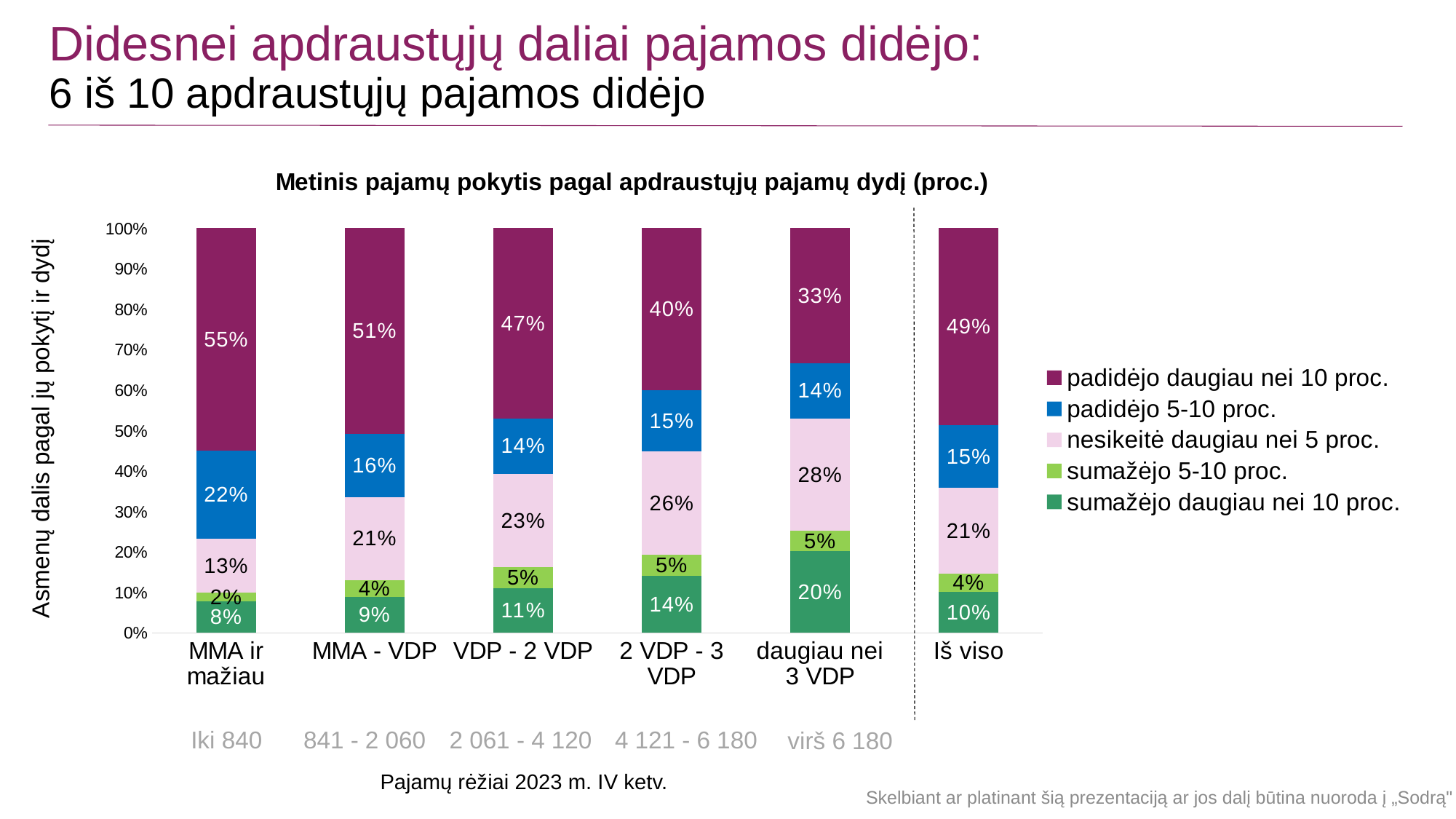
What is the value of 'padidėjo daugiau nei 10 proc.' for the 'MMA ir mažiau' category? 55% What is the difference between the 'padidėjo daugiau nei 10 proc.' values for 'MMA ir mažiau' and 'daugiau nei 3 VDP'? 22 percentage points What is the value of 'nesikeitė daugiau nei 5 proc.' for the 'Iš viso' bar? 21% Does the 'padidėjo daugiau nei 10 proc.' share rise or fall from 'MMA ir mažiau' to 'daugiau nei 3 VDP'? Fall Which has a larger 'nesikeitė daugiau nei 5 proc.' value: '2 VDP - 3 VDP' or 'MMA - VDP'? 2 VDP - 3 VDP Which category has the highest value for 'padidėjo daugiau nei 10 proc.'? MMA ir mažiau What kind of chart is shown on the slide? Stacked bar chart What is the title of the chart? Metinis pajamų pokytis pagal apdraustųjų pajamų dydį (proc.) Which category has the lowest value for 'sumažėjo 5-10 proc.'? MMA ir mažiau How many categories (bars) are shown on the x axis? 6 What is the value of 'sumažėjo daugiau nei 10 proc.' for the 'daugiau nei 3 VDP' category? 20% How many series does the legend list? 5